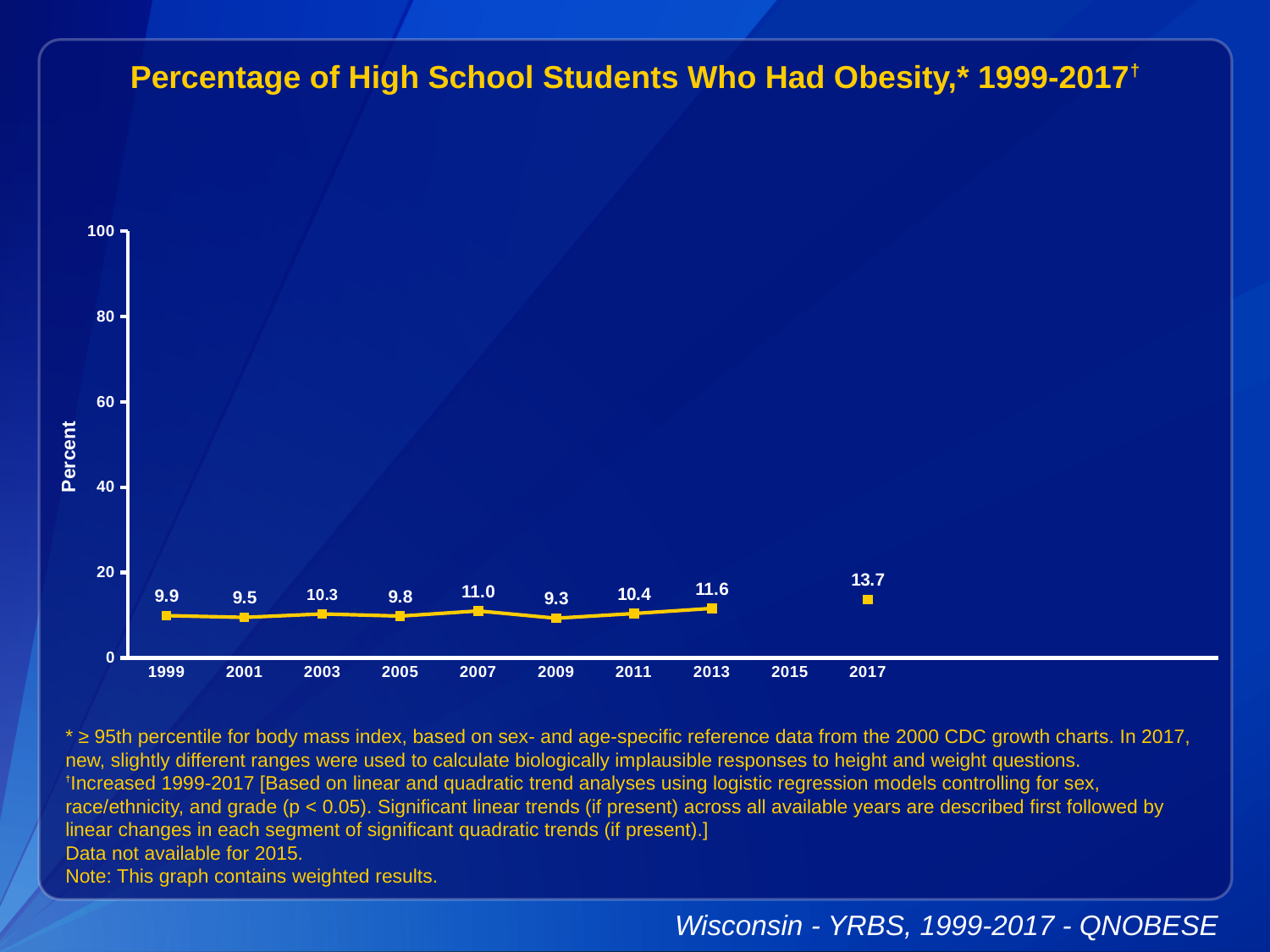
What value is shown for 2009? 9.3 What was the percentage of high school students who had obesity in 1999? 9.9 Which year has the lowest percentage of students who had obesity? 2009 How many years have a data point plotted on the chart? 9 Which year has a higher value, 2007 or 2013? 2013 Is the value for 2011 greater or less than 20? less Which year has the highest percentage of students who had obesity? 2017 What kind of chart is shown on the slide? line chart Overall, do the values rise or fall from 1999 to 2017? rise What was the percentage of high school students who had obesity in 2017? 13.7 What is the difference between the 2017 value and the 1999 value? 3.8 For which year on the x axis is no data shown? 2015